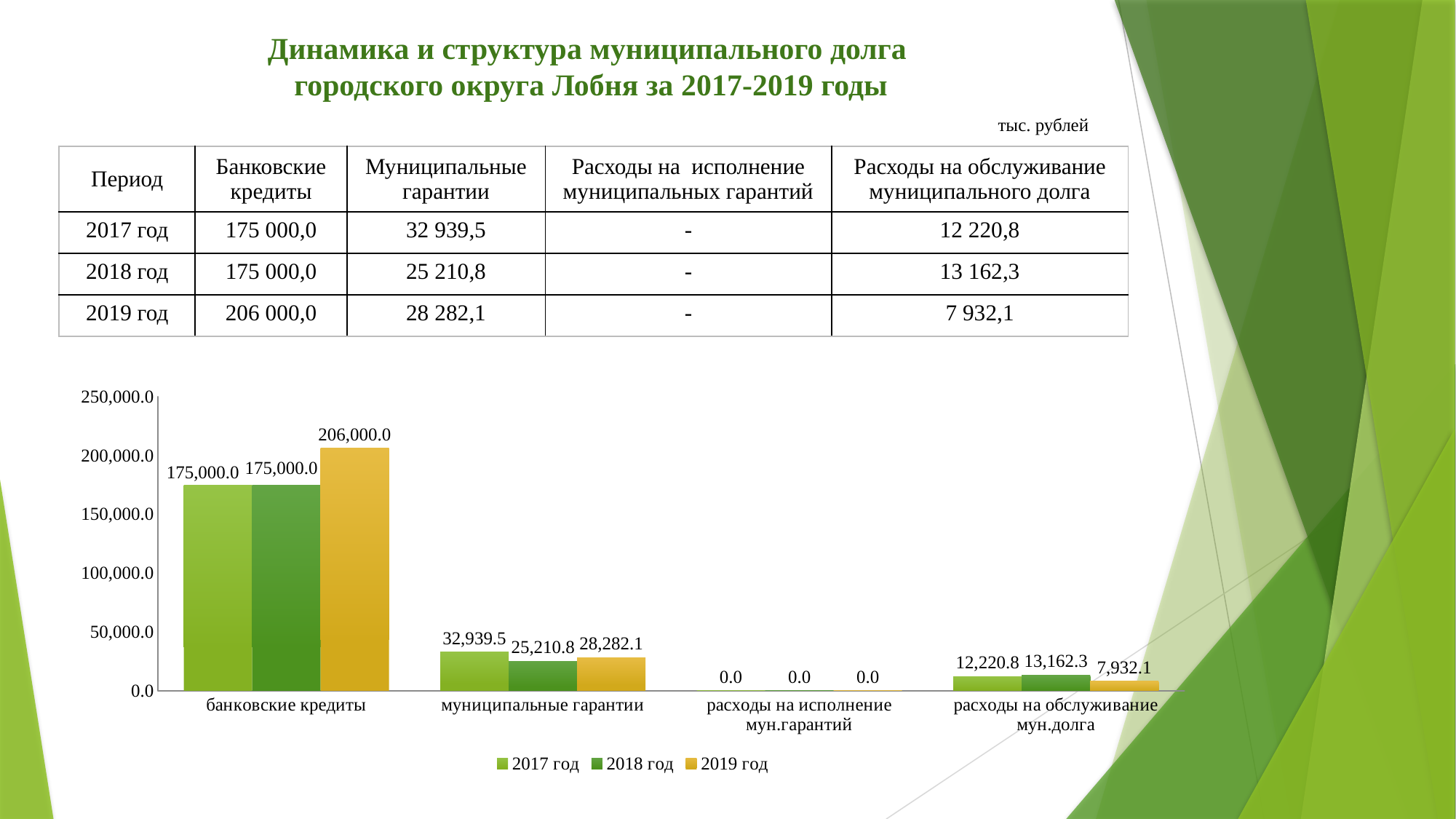
Which year has the lowest value for муниципальные гарантии? 2018 год Is the 2019 год value for банковские кредиты greater or less than 200,000.0? greater What is the value for банковские кредиты in the 2019 год series? 206,000.0 How many series does the chart legend list? 3 Which is larger for муниципальные гарантии: the 2017 год value or the 2019 год value? 2017 год What is the value for расходы на исполнение мун.гарантий in the 2018 год series? 0.0 What kind of chart is shown on the slide? bar chart What is the difference between the 2019 год and 2017 год values for банковские кредиты? 31,000.0 How many categories are shown on the x axis of the chart? 4 What is the value for муниципальные гарантии in the 2018 год series? 25,210.8 Which year has the highest value for расходы на обслуживание мун.долга? 2018 год What is the value for расходы на обслуживание мун.долга in the 2017 год series? 12,220.8